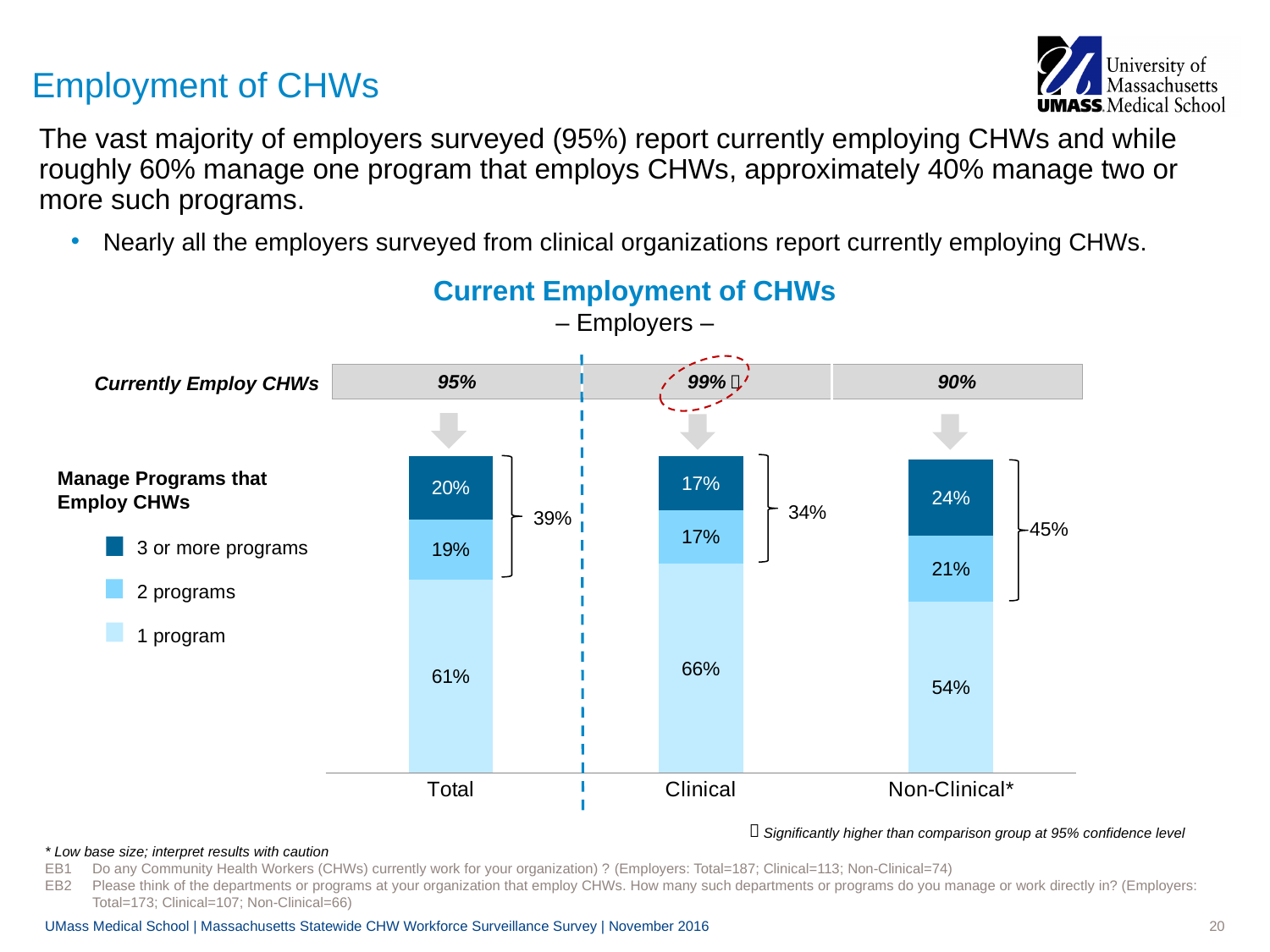
What percentage of Total employers manage 1 program that employs CHWs? 61% How many series does the legend list? 3 What percentage of Non-Clinical employers manage 2 programs that employ CHWs? 21% What percentage of Clinical employers manage 3 or more programs that employ CHWs? 17% Which is larger: the 3 or more programs share for Non-Clinical or for Total? Non-Clinical Which category has the highest share of employers managing 1 program? Clinical What is the difference between the 1 program share for Clinical and for Non-Clinical? 12% How many categories are shown on the x axis of the chart? 3 What kind of chart is shown on the slide? Stacked bar chart What percentage of Clinical employers currently employ CHWs? 99% What is the combined share of employers managing 2 or more programs in the Non-Clinical category, as labelled by the bracket? 45% Which category has the lowest share of employers managing 1 program? Non-Clinical*